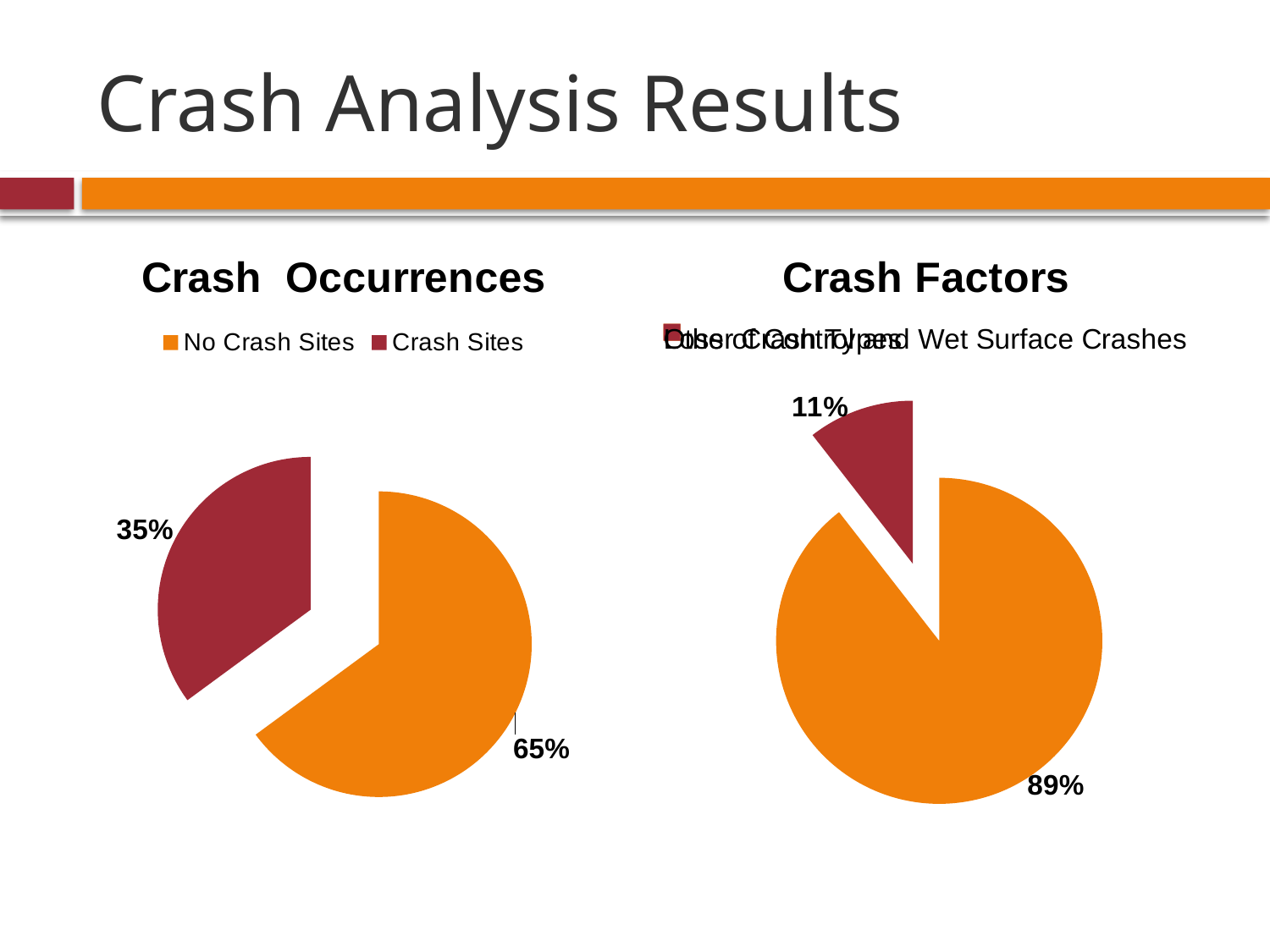
In the Crash Occurrences chart, which category has the largest share? No Crash Sites In the Crash Factors chart, what percentage is shown on the small red slice? 11% In the Crash Occurrences chart, which is larger, No Crash Sites or Crash Sites? No Crash Sites In the Crash Factors chart, what percentage is shown on the large orange slice? 89% In the Crash Occurrences chart, what is the difference in percentage points between No Crash Sites and Crash Sites? 30 In the Crash Occurrences chart, what percentage is shown for No Crash Sites? 65% In the Crash Occurrences chart, what percentage is shown for Crash Sites? 35% In the Crash Occurrences chart, what colour is the Crash Sites slice? Dark red In the Crash Occurrences chart, which category has the smallest share? Crash Sites What kind of chart is the Crash Occurrences chart? Pie chart How many series does the legend of the Crash Occurrences chart list? 2 How many slices does the Crash Factors pie chart have? 2